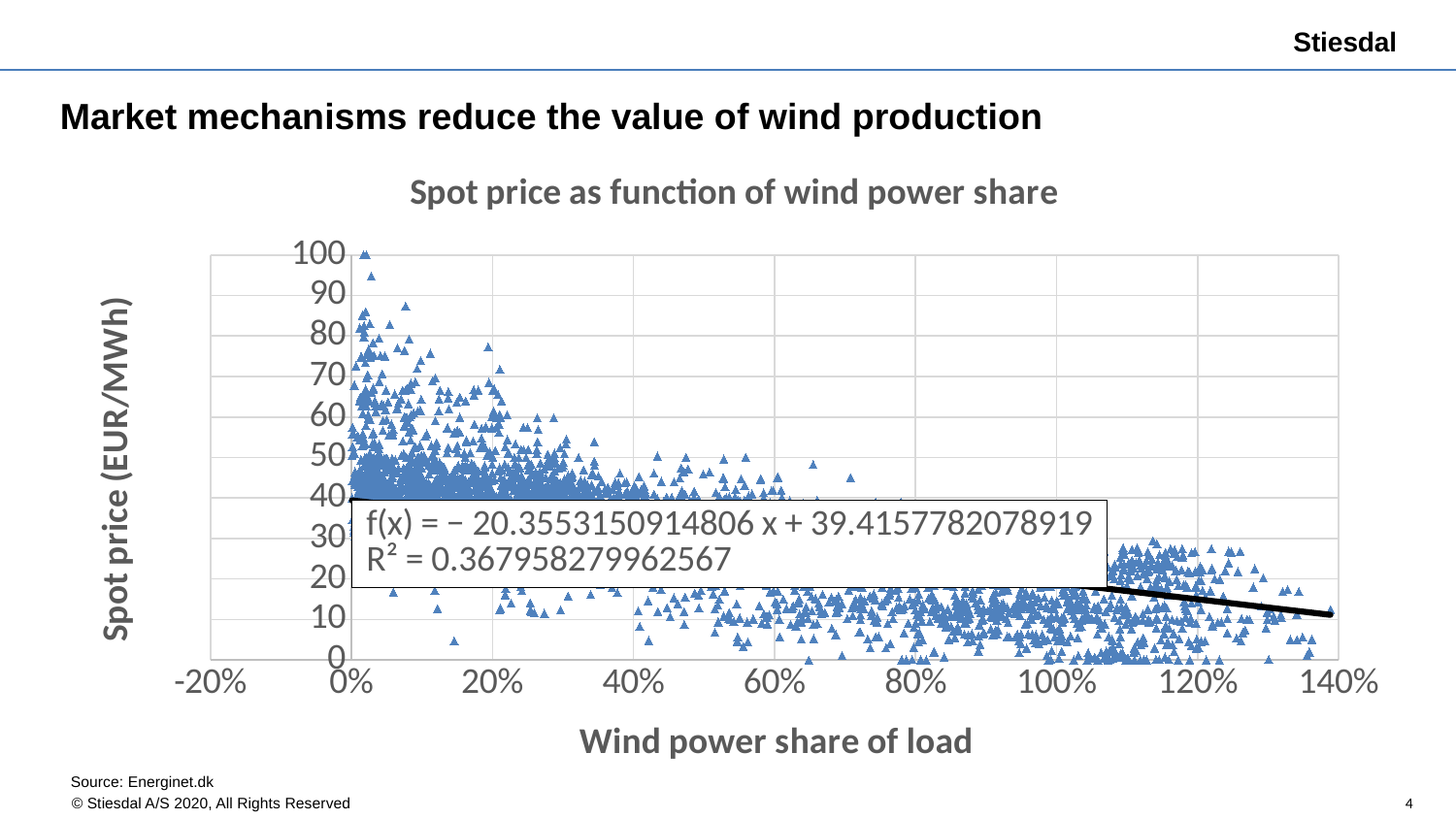
According to the trendline equation shown on the chart, what is the slope of the fitted line? − 20.3553150914806 What is the label of the vertical axis? Spot price (EUR/MWh) What kind of chart is shown on the slide? Scatter chart What R² value is displayed on the chart? 0.367958279962567 Is the trendline value at a wind power share of 0% greater or less than 30 EUR/MWh? greater Are the spot prices at a wind power share of around 120% mostly greater or less than 40 EUR/MWh? less Does the spot price tend to rise or fall as the wind power share of load increases? Fall What is the title of the chart? Spot price as function of wind power share Is the trendline value at a wind power share of 140% greater or less than 20 EUR/MWh? less According to the trendline equation shown on the chart, what is the intercept of the fitted line? 39.4157782078919 What is the highest value shown on the vertical axis? 100